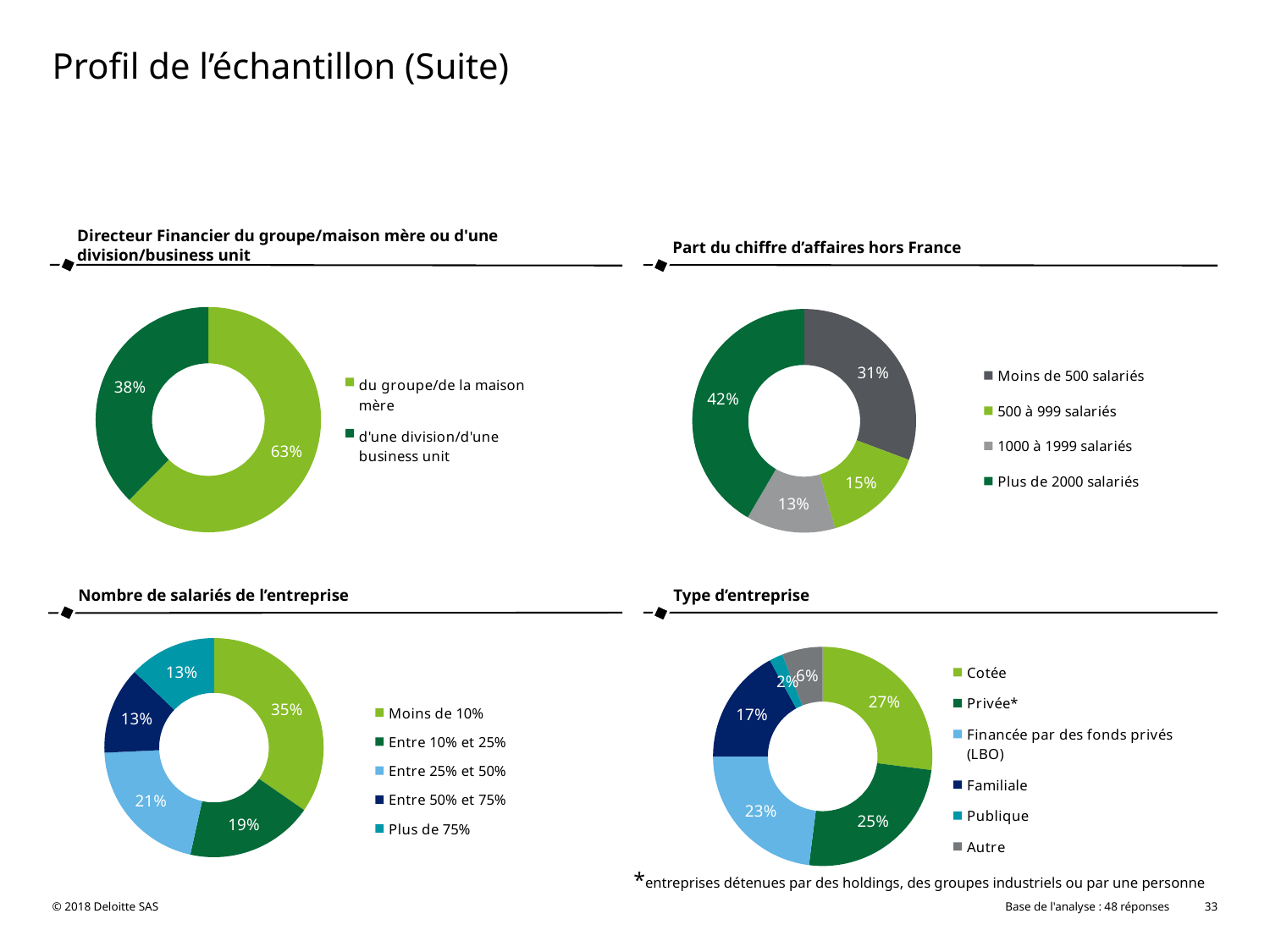
In the bottom-left chart 'Nombre de salariés de l'entreprise', which category has the largest slice? Moins de 10% In the top-right chart 'Part du chiffre d'affaires hors France', what is the value for '500 à 999 salariés'? 15% In the top-right chart 'Part du chiffre d'affaires hors France', what is the difference between the 'Plus de 2000 salariés' slice and the 'Moins de 500 salariés' slice? 11 percentage points In the top-left chart 'Directeur Financier du groupe/maison mère ou d'une division/business unit', what is the value for 'du groupe/de la maison mère'? 63% In the bottom-left chart 'Nombre de salariés de l'entreprise', what is the value for 'Entre 25% et 50%'? 21% In the bottom-right chart 'Type d'entreprise', what is the value for 'Financée par des fonds privés (LBO)'? 23% In the bottom-right chart 'Type d'entreprise', which category has the smallest slice? Publique What kind of chart is used in the top-left chart titled 'Directeur Financier du groupe/maison mère ou d'une division/business unit'? Donut (pie) chart In the top-right chart 'Part du chiffre d'affaires hors France', which legend category has the largest slice? Plus de 2000 salariés How many categories does the legend list in the bottom-left chart 'Nombre de salariés de l'entreprise'? 5 In the top-left chart 'Directeur Financier du groupe/maison mère ou d'une division/business unit', what is the value for 'd'une division/d'une business unit'? 38% In the bottom-right chart 'Type d'entreprise', which is larger: 'Cotée' or 'Familiale'? Cotée